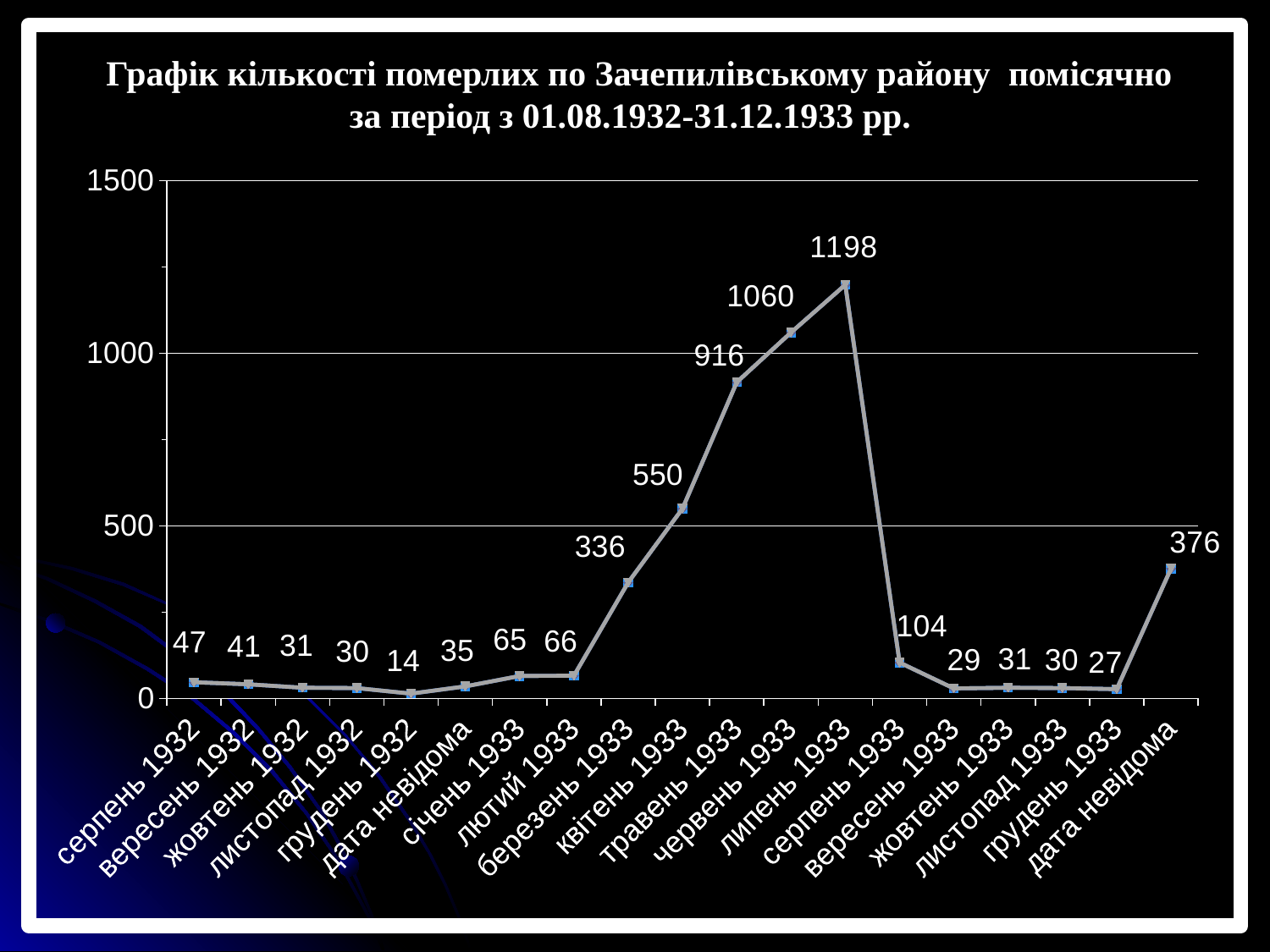
What is the value for липень 1933? 1198 Which is larger, the value for травень 1933 or the value for квітень 1933? травень 1933 What is the difference between the values for липень 1933 and червень 1933? 138 How many data points are plotted on the chart? 19 What is the value for серпень 1933? 104 Do the values rise or fall from березень 1933 to липень 1933? rise What is the value for березень 1933? 336 Which category has the lowest value? грудень 1932 Is the value for червень 1933 greater or less than 1000? greater What kind of chart is shown on the slide? line chart Which month has the highest value? липень 1933 What is the value for грудень 1932? 14